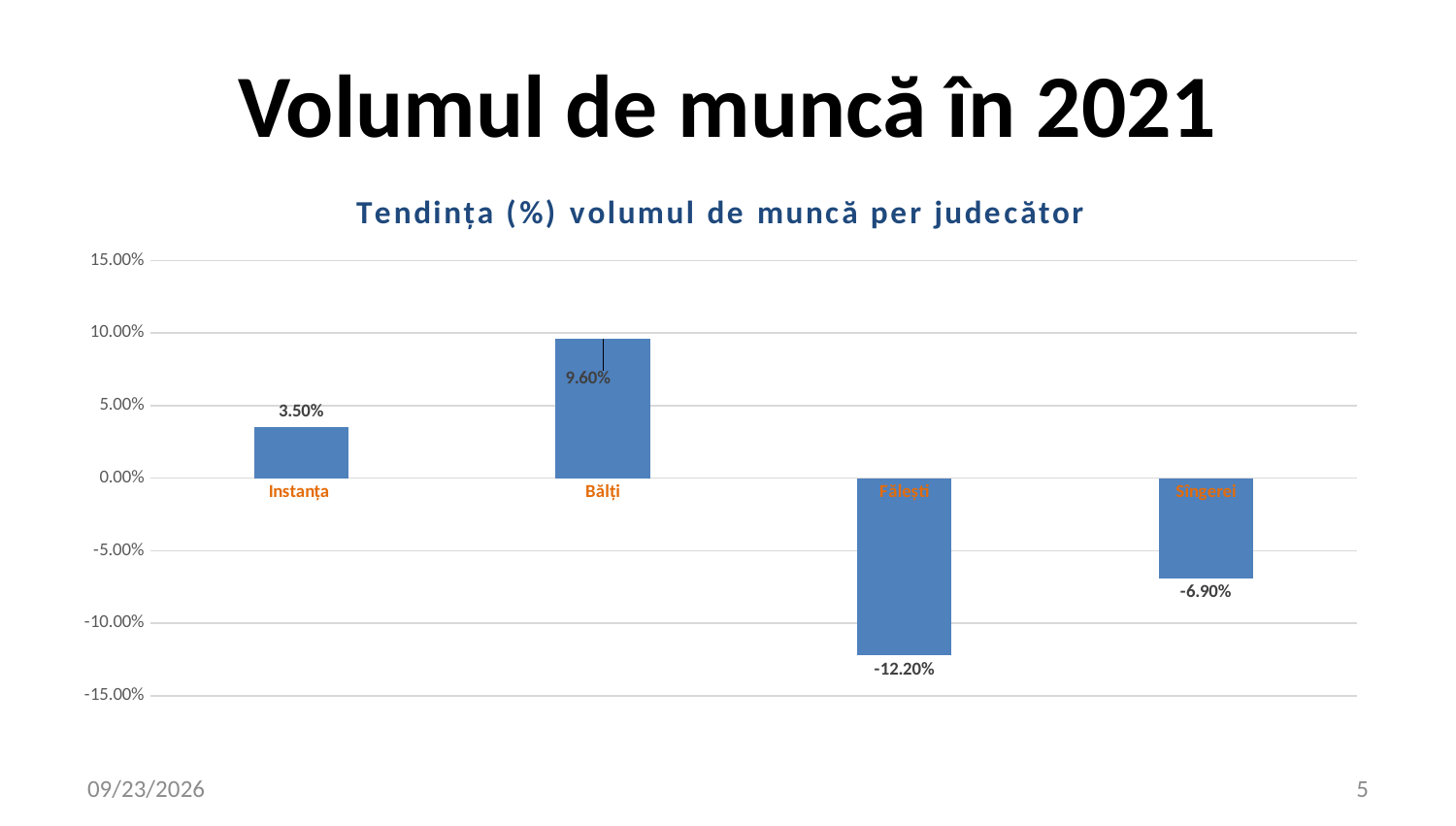
What is the title of the chart? Tendința (%) volumul de muncă per judecător What is the value for Fălești? -12.20% Which category has the highest value? Bălți What is the difference between the values for Bălți and Instanța? 6.10% How many categories are shown in the chart? 4 Which category has the lowest value? Fălești What kind of chart is shown on the slide? bar chart Which is larger, the value for Sîngerei or the value for Fălești? Sîngerei What is the value for Bălți? 9.60% What is the value for Instanța? 3.50% Is the value for Fălești greater or less than -10.00%? less What is the value for Sîngerei? -6.90%